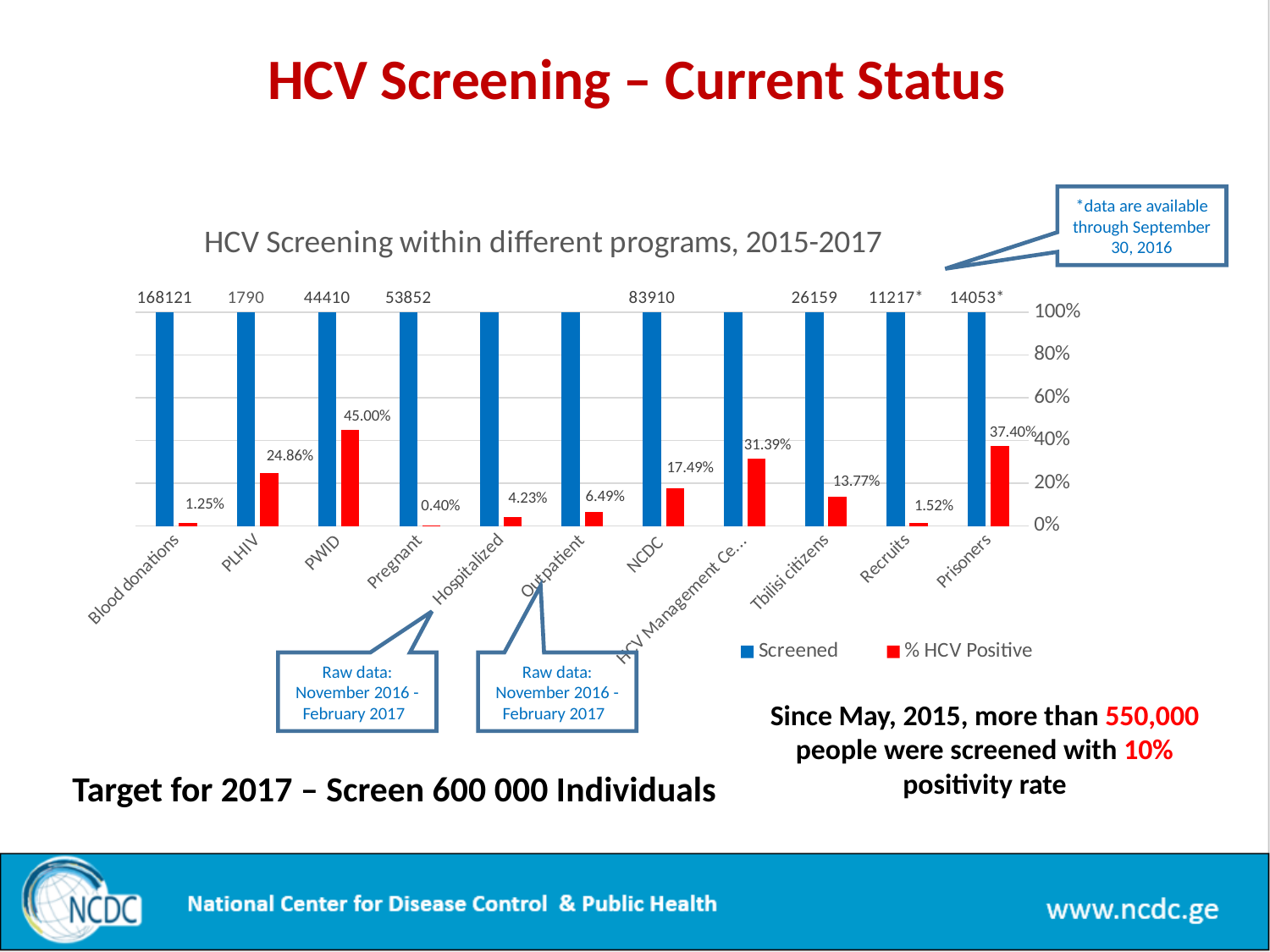
What kind of chart is shown on the slide? Bar chart Which program has the highest % HCV Positive? PWID Which has a higher % HCV Positive, Prisoners or HCV Management Ce...? Prisoners What is the title of the chart? HCV Screening within different programs, 2015-2017 How many people were screened in the Blood donations program? 168121 How many series does the legend list? 2 What is the Screened value for NCDC? 83910 Which program has the lowest % HCV Positive? Pregnant What is the % HCV Positive value for PWID? 45.00% How many programs (categories) are shown on the x axis? 11 What is the difference in % HCV Positive between PWID and PLHIV? 20.14% What is the % HCV Positive value for Tbilisi citizens? 13.77%